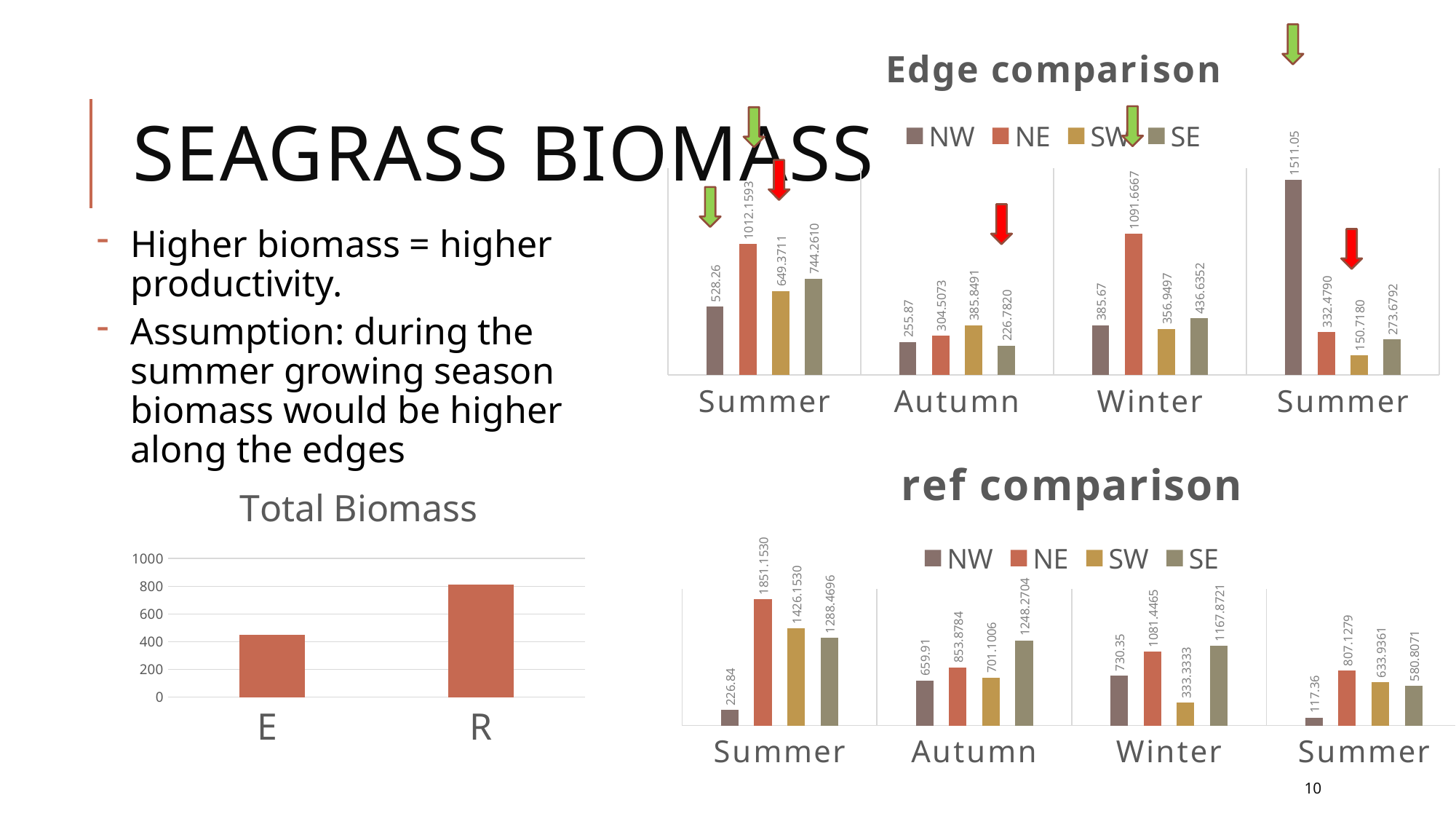
In the Edge comparison chart, what is the value for NE in Winter? 1091.6667 In the ref comparison chart, which series has the lowest value in the first Summer group? NW In the Edge comparison chart, what is the value for NW in the last Summer group? 1511.05 In the Total Biomass chart, is the value for E greater or less than 600? less In the Edge comparison chart, which series has the highest value in Autumn? SW What kind of chart is the Total Biomass chart? bar chart In the Edge comparison chart, what is the difference between NE and NW in the first Summer group? 483.8993 In the ref comparison chart, which is larger in Winter, NE or SE? SE In the ref comparison chart, what is the value for SW in Autumn? 701.1006 How many series does the legend of the Edge comparison chart list? 4 How many categories are shown in the Total Biomass chart? 2 In the Total Biomass chart, which bar is higher, E or R? R